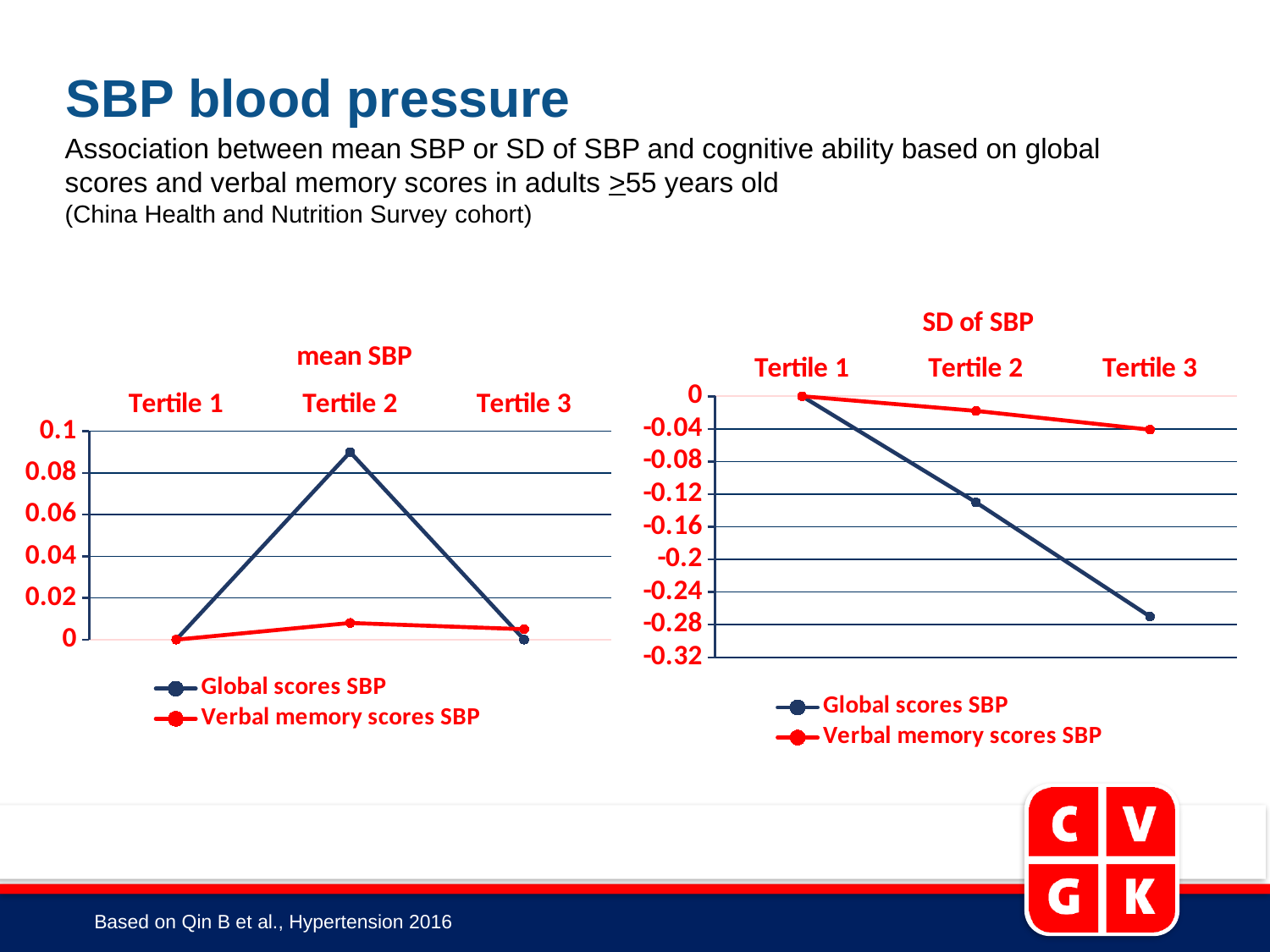
In the SD of SBP chart, do the Global scores SBP values rise or fall from Tertile 1 to Tertile 3? fall In the mean SBP chart, what kind of chart is shown? line chart In the mean SBP chart, what colour is the line for Verbal memory scores SBP? red In the SD of SBP chart, is the value for Global scores SBP at Tertile 3 greater or less than -0.24? less In the mean SBP chart, is the value for Global scores SBP at Tertile 2 greater or less than 0.08? greater In the mean SBP chart, how many tertile categories are plotted along the x axis? 3 In the mean SBP chart, what is the value for Global scores SBP at Tertile 1? 0 In the SD of SBP chart, how many series does the legend list? 2 In the SD of SBP chart, what is the value for Verbal memory scores SBP at Tertile 1? 0 In the mean SBP chart, at which tertile is Global scores SBP highest? Tertile 2 In the SD of SBP chart, at which tertile is Global scores SBP lowest? Tertile 3 In the SD of SBP chart, which series has the larger value at Tertile 2, Global scores SBP or Verbal memory scores SBP? Verbal memory scores SBP